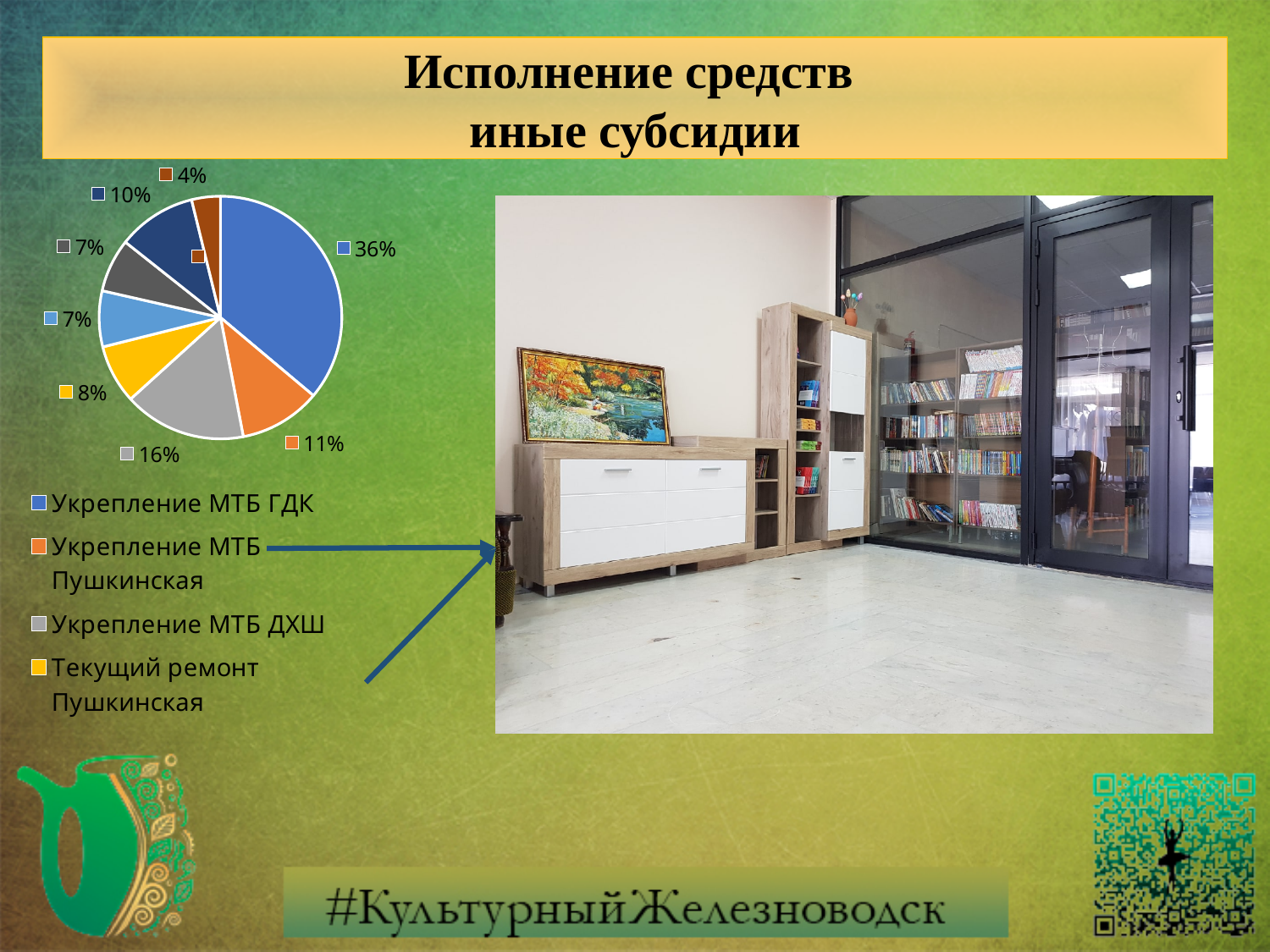
What is the title of the slide containing the pie chart? Исполнение средств иные субсидии What percentage does the pie chart show for Укрепление МТБ ГДК? 36% What percentage does the pie chart show for Укрепление МТБ Пушкинская? 11% How many entries does the chart legend list? 4 What colour is the slice for Укрепление МТБ ГДК in the pie chart? Blue What kind of chart is shown on the slide? Pie chart By how many percentage points does Укрепление МТБ ДХШ exceed Текущий ремонт Пушкинская? 8 percentage points By how many percentage points does Укрепление МТБ ГДК exceed Укрепление МТБ Пушкинская? 25 percentage points What percentage does the pie chart show for Текущий ремонт Пушкинская? 8% Which is larger in the pie chart: Укрепление МТБ ДХШ or Укрепление МТБ Пушкинская? Укрепление МТБ ДХШ Which legend category has the largest slice of the pie chart? Укрепление МТБ ГДК What percentage does the pie chart show for Укрепление МТБ ДХШ? 16%